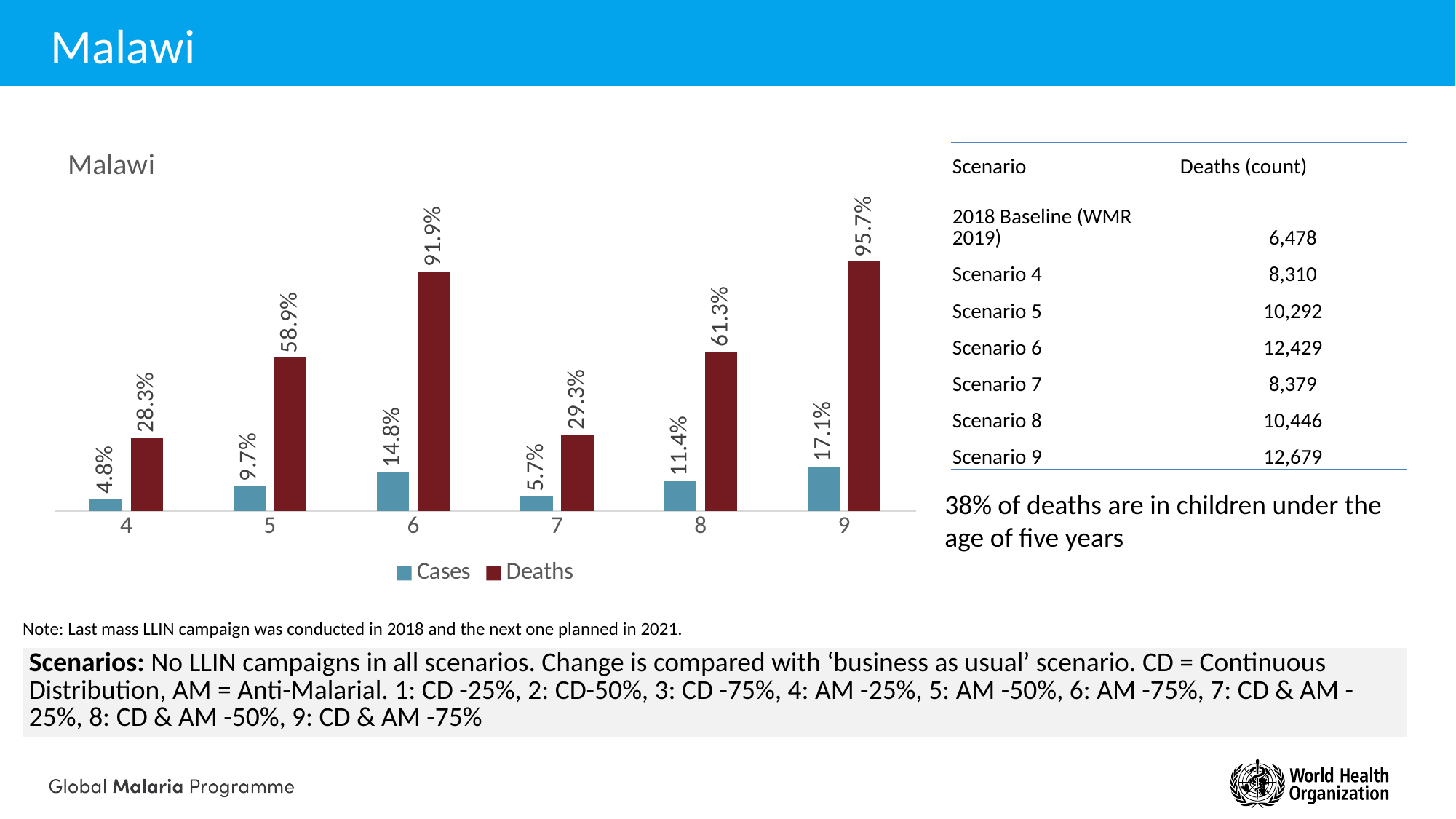
How many scenarios are shown on the x axis of the chart? 6 What is the difference between the Deaths values for scenario 6 and scenario 5? 33.0% What is the Deaths value for scenario 9? 95.7% Do the Cases values rise or fall from scenario 7 to scenario 9? Rise Which scenario has the highest Deaths value? 9 How many series does the chart legend list? 2 What is the Cases value for scenario 6? 14.8% What kind of chart is shown on the slide? Bar chart What is the Deaths value for scenario 4? 28.3% Which scenario has the lowest Cases value? 4 What is the title of the chart? Malawi Which is larger, the Cases value for scenario 8 or the Cases value for scenario 5? Scenario 8